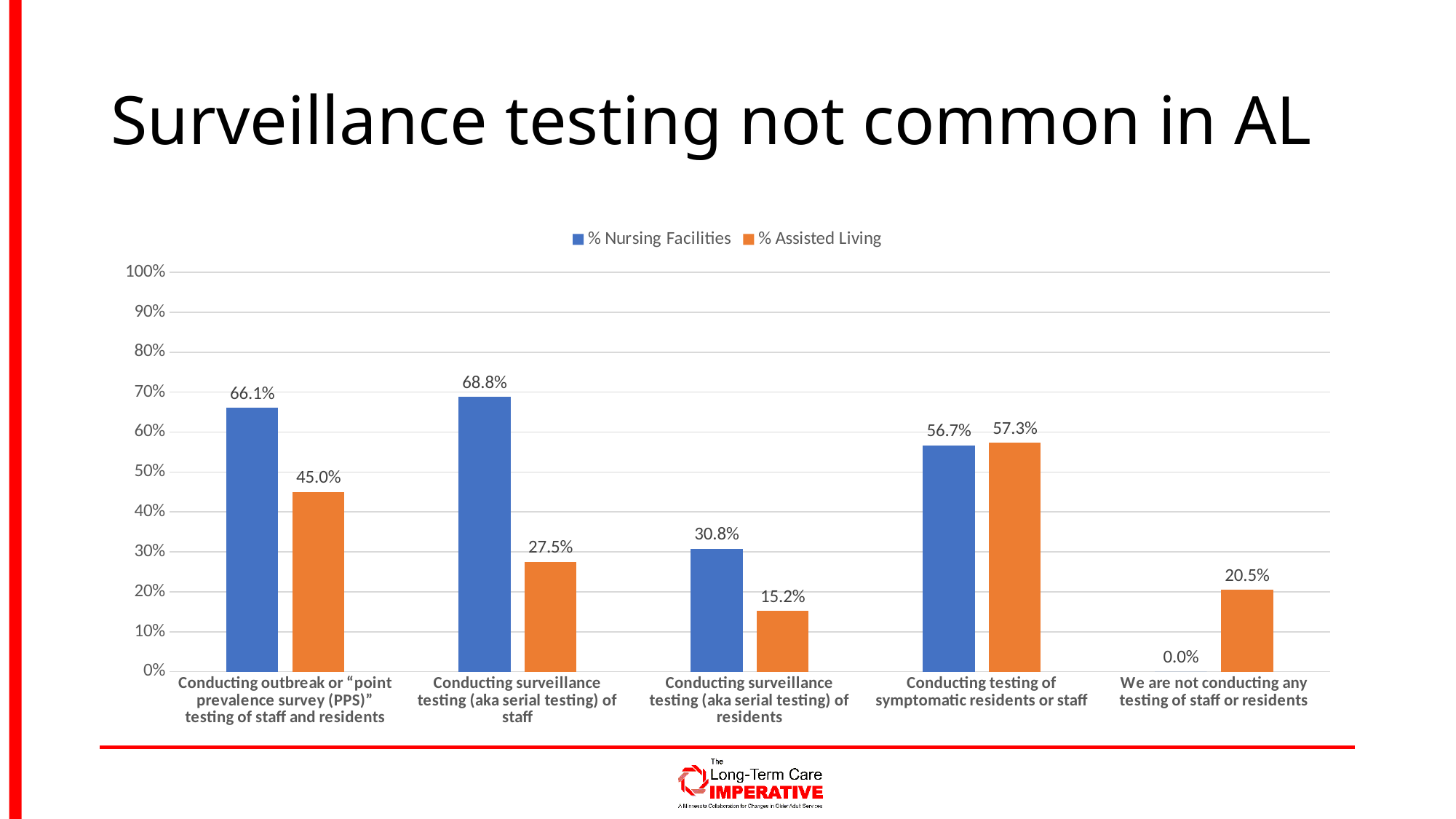
What is the % Nursing Facilities value for "Conducting surveillance testing (aka serial testing) of staff"? 68.8% Which category has the lowest % Assisted Living value? Conducting surveillance testing (aka serial testing) of residents Is the % Assisted Living value for "Conducting testing of symptomatic residents or staff" greater or less than 50%? greater What colour represents the % Assisted Living series? Orange How many categories are shown on the x axis? 5 For "Conducting outbreak or "point prevalence survey (PPS)" testing of staff and residents", which series has the larger value, % Nursing Facilities or % Assisted Living? % Nursing Facilities What is the difference between the % Nursing Facilities and % Assisted Living values for "Conducting surveillance testing (aka serial testing) of staff"? 41.3% Which category has the highest % Nursing Facilities value? Conducting surveillance testing (aka serial testing) of staff What is the % Assisted Living value for "Conducting surveillance testing (aka serial testing) of residents"? 15.2% What kind of chart is shown on the slide? Bar chart How many series does the legend list? 2 What is the % Nursing Facilities value for "We are not conducting any testing of staff or residents"? 0.0%